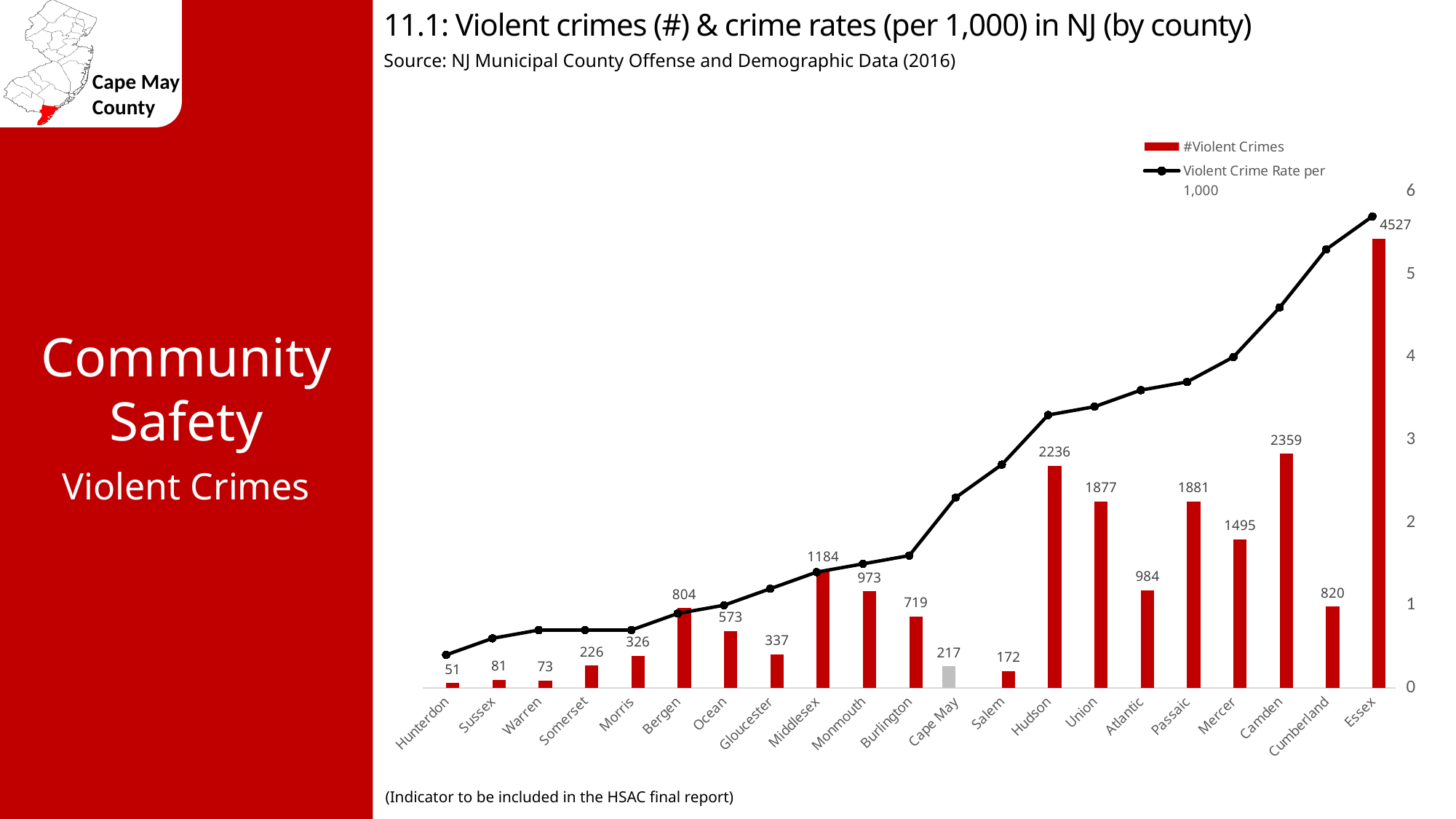
Which county has the highest number of violent crimes? Essex What is the difference in the number of violent crimes between Camden and Hudson? 123 What is the number of violent crimes for Essex? 4527 How many series does the legend list? 2 Is the violent crime rate per 1,000 for Hunterdon greater or less than 1? less What is the number of violent crimes for Cape May? 217 Which county has the lowest number of violent crimes? Hunterdon Does the violent crime rate per 1,000 line rise or fall from Hunterdon to Essex? rise Is the violent crime rate per 1,000 for Essex greater or less than 5? greater Which county has more violent crimes, Union or Passaic? Passaic How many counties are shown on the x axis? 21 What is the number of violent crimes for Hudson? 2236